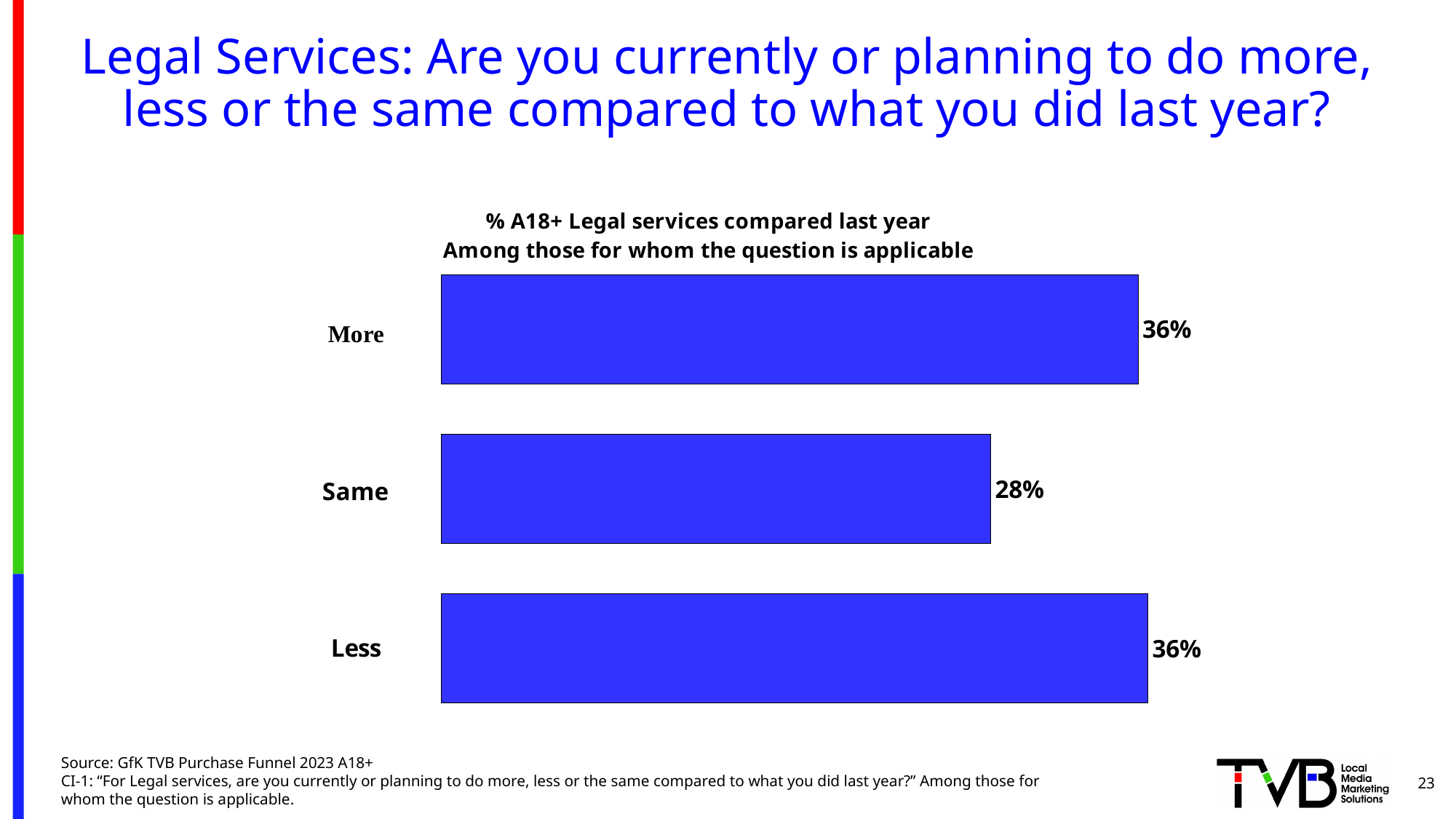
What is the value for the 'Less' category? 36% What percentage of respondents said they plan to do more legal services compared to last year? 36% How many categories are shown in the chart? 3 Which is larger, the value for 'Same' or the value for 'Less'? Less What is the value for the 'Same' category? 28% What is the title of the chart? % A18+ Legal services compared last year Among those for whom the question is applicable What colour are the bars in the chart? Blue What is the difference between the 'Less' and 'Same' values? 8 percentage points What is the difference between the 'More' and 'Same' values? 8 percentage points Which category has the lowest value? Same What type of chart is shown on the slide? Bar chart Do 'More' and 'Less' have the same value? Yes, both 36%